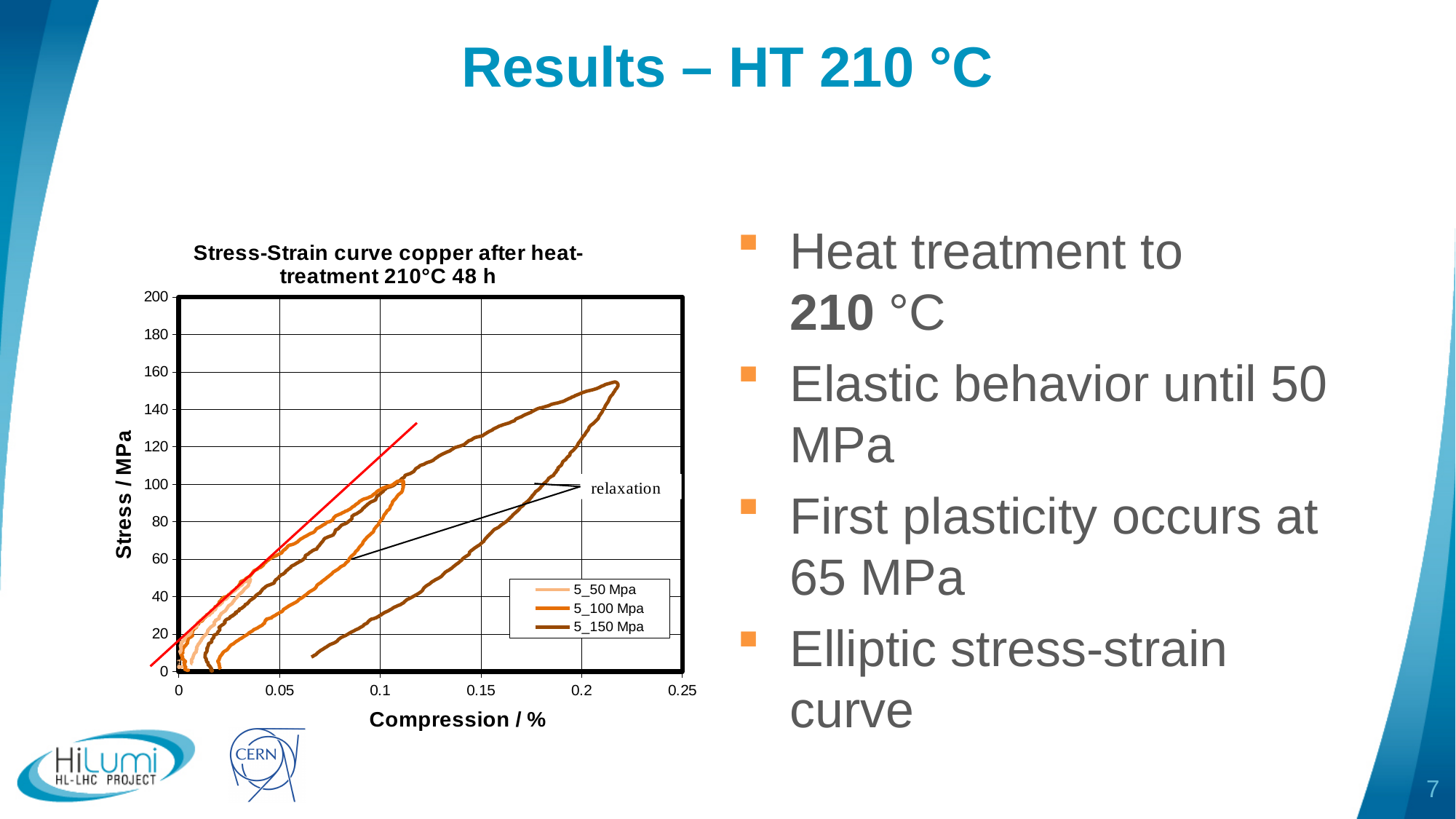
Is the maximum compression reached by the 5_100 Mpa series greater or less than 0.15? less Which series reaches the lowest peak stress in the chart? 5_50 Mpa Is the maximum compression reached by the 5_150 Mpa series greater or less than 0.2? greater What is the title of the chart? Stress-Strain curve copper after heat-treatment 210°C 48 h Is the peak stress of the 5_150 Mpa series greater or less than 140? greater What is the label of the y axis of the chart? Stress / MPa Which series reaches the highest stress in the chart? 5_150 Mpa Which series reaches a higher peak stress, 5_100 Mpa or 5_50 Mpa? 5_100 Mpa What type of chart is shown on the slide? line chart How many series does the chart legend list? 3